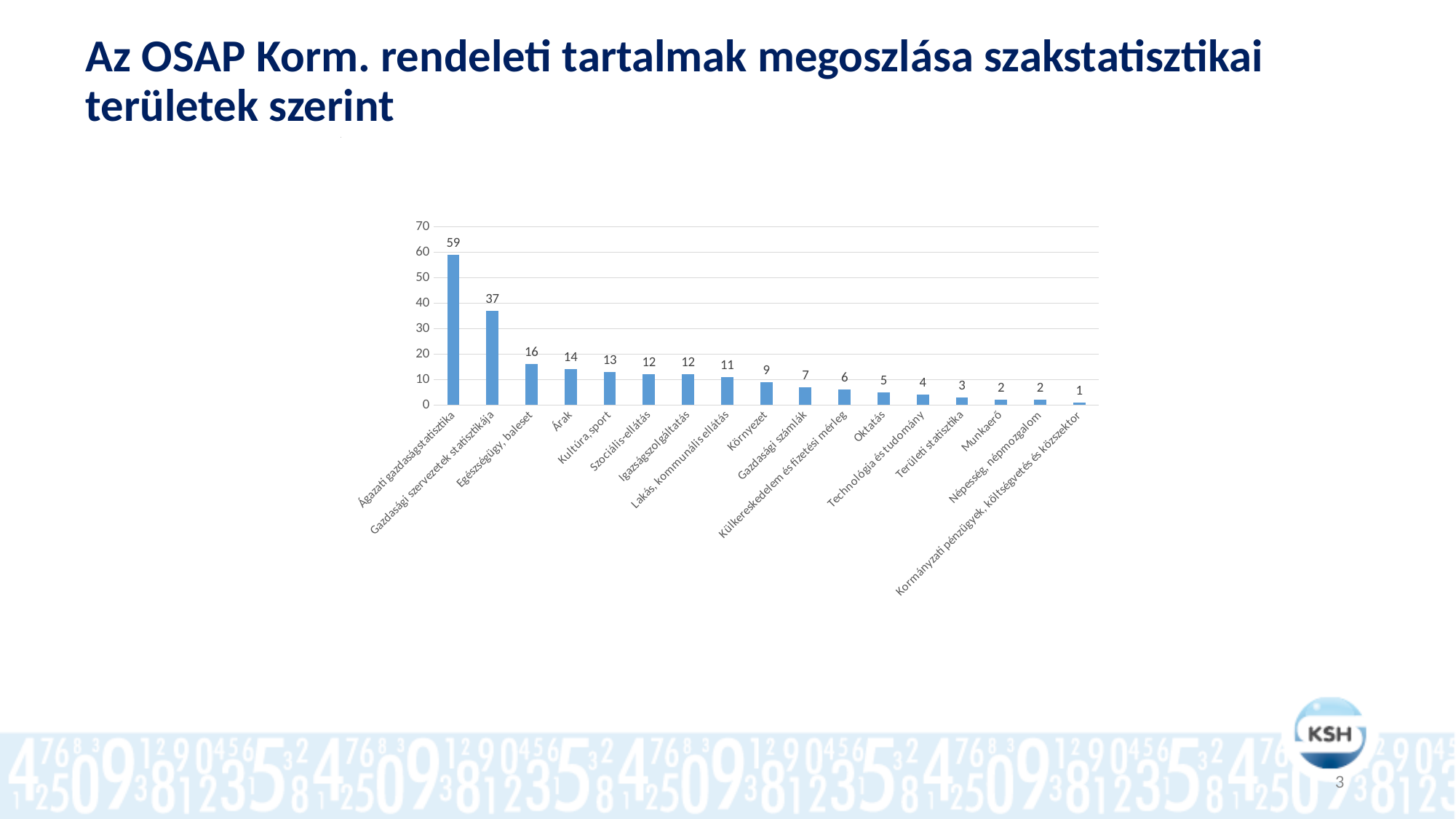
What is the value for Oktatás? 5 What is the value for Egészségügy, baleset? 16 What kind of chart is shown on the slide? bar chart Which is larger, the value for Árak or the value for Kultúra, sport? Árak How many categories are shown on the x axis? 17 What is the value for Környezet? 9 What is the value for Ágazati gazdaságstatisztika? 59 Which category has the highest value? Ágazati gazdaságstatisztika What is the difference between the values for Ágazati gazdaságstatisztika and Gazdasági szervezetek statisztikája? 22 Do the values rise or fall from left to right along the x axis? fall Is the value for Gazdasági szervezetek statisztikája greater or less than 30? greater Which category has the lowest value? Kormányzati pénzügyek, költségvetés és közszektor